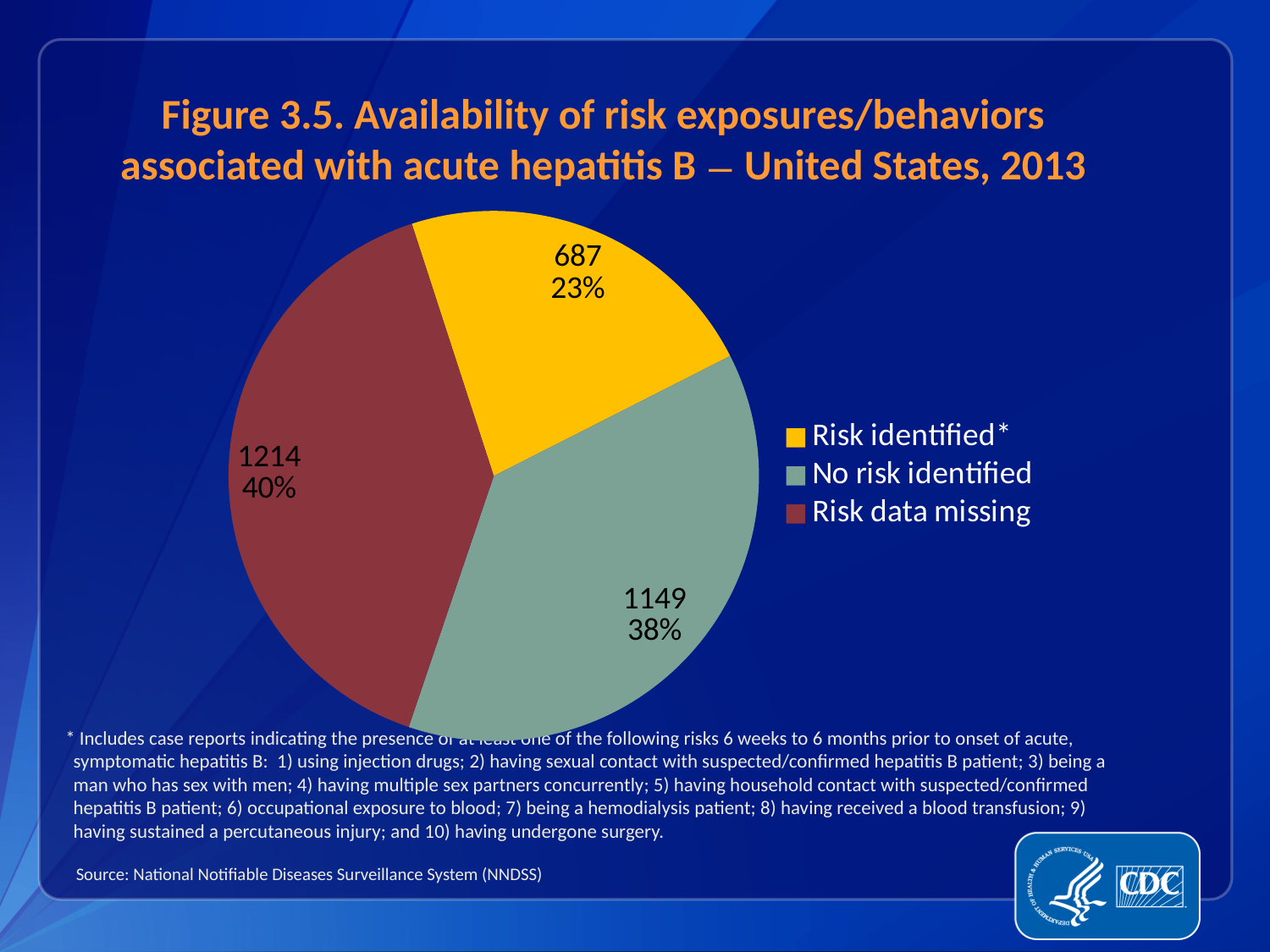
What is the total number of cases across all three slices? 3050 Which category has the largest slice of the pie? Risk data missing How many cases are in the 'Risk identified*' slice? 687 What is the difference in cases between 'Risk data missing' and 'No risk identified'? 65 How many categories does the pie chart show? 3 How many cases are in the 'Risk data missing' slice? 1214 What percentage of the pie is 'No risk identified'? 38% What percentage of the pie is 'Risk data missing'? 40% Which has more cases, 'Risk identified*' or 'No risk identified'? No risk identified What type of chart is shown on the slide? pie chart Which category has the smallest slice of the pie? Risk identified* What colour is the 'No risk identified' slice? grey-green